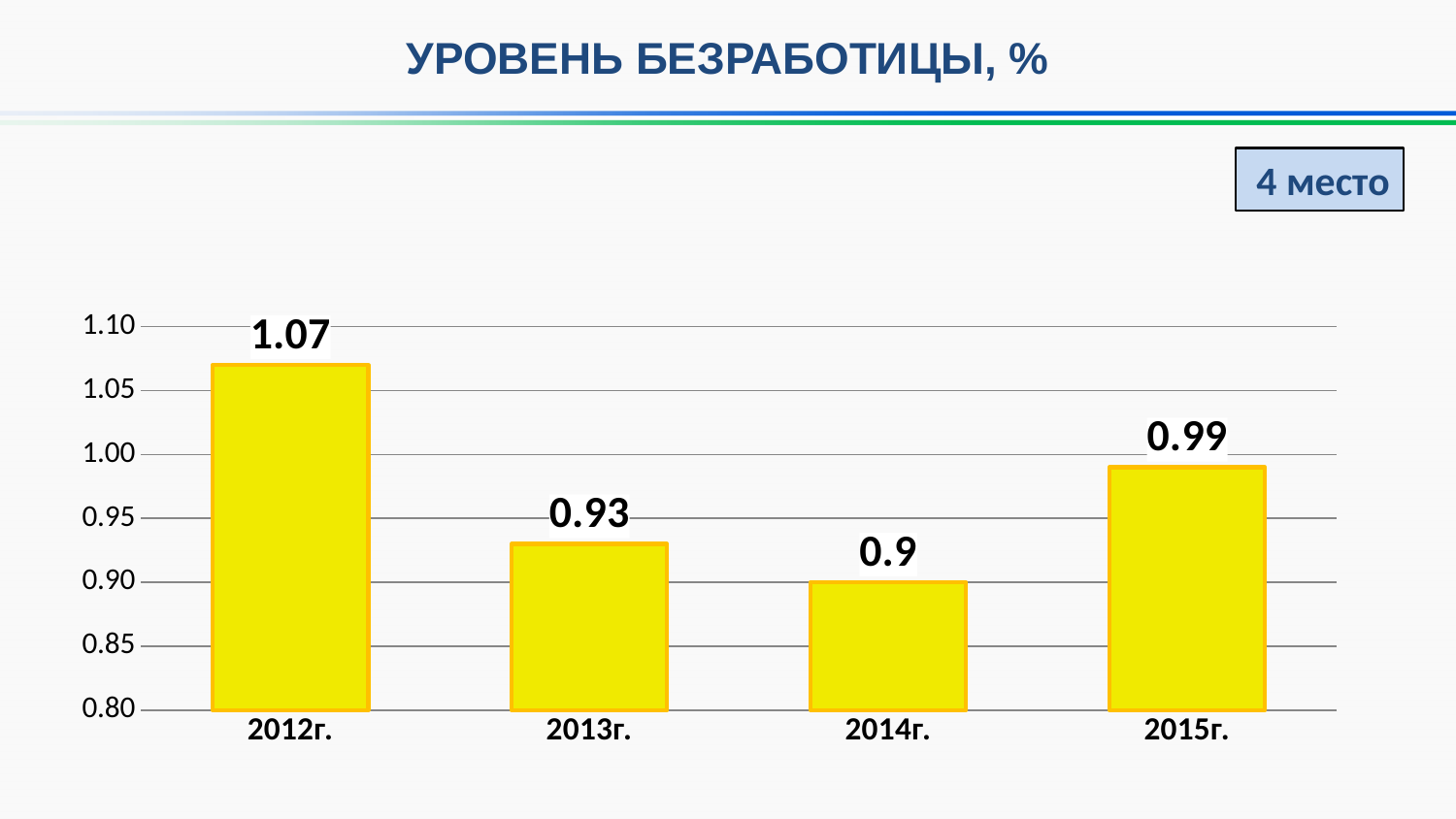
Which year has the highest unemployment rate? 2012г. What is the unemployment rate value shown for 2012г.? 1.07 What is the difference between the values for 2015г. and 2013г.? 0.06 What is the title of the chart? УРОВЕНЬ БЕЗРАБОТИЦЫ, % What is the value shown for 2015г.? 0.99 What is the value shown for 2014г.? 0.9 Which year has the lowest unemployment rate? 2014г. How many years are shown on the chart? 4 Which is larger, the value for 2013г. or the value for 2015г.? 2015г. Is the value for 2013г. greater or less than 0.95? less What kind of chart is shown on the slide? bar chart What is the difference between the values for 2012г. and 2014г.? 0.17